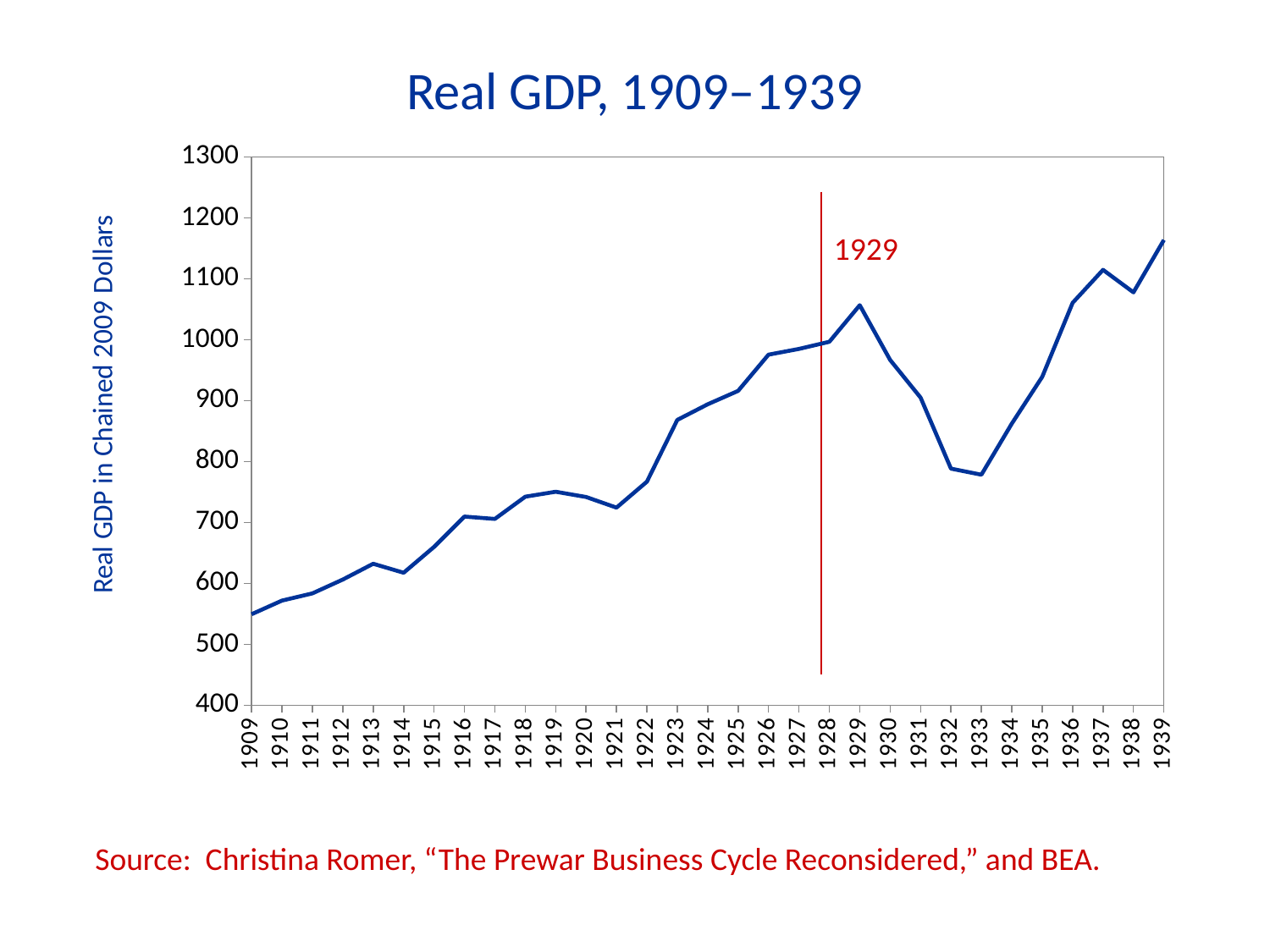
Is the value for 1929 greater or less than 1000? greater Which year has the lowest real GDP value on the chart? 1909 Is the value for 1921 greater or less than 800? less Does real GDP rise or fall between 1929 and 1933? fall How many years are plotted on the x axis of the chart? 31 Which year has the larger real GDP value, 1929 or 1933? 1929 What kind of chart is shown on the slide? line chart Is the value for 1933 greater or less than 800? less What is the label on the vertical axis of the chart? Real GDP in Chained 2009 Dollars Which year has the highest real GDP value on the chart? 1939 What is the title of the chart? Real GDP, 1909–1939